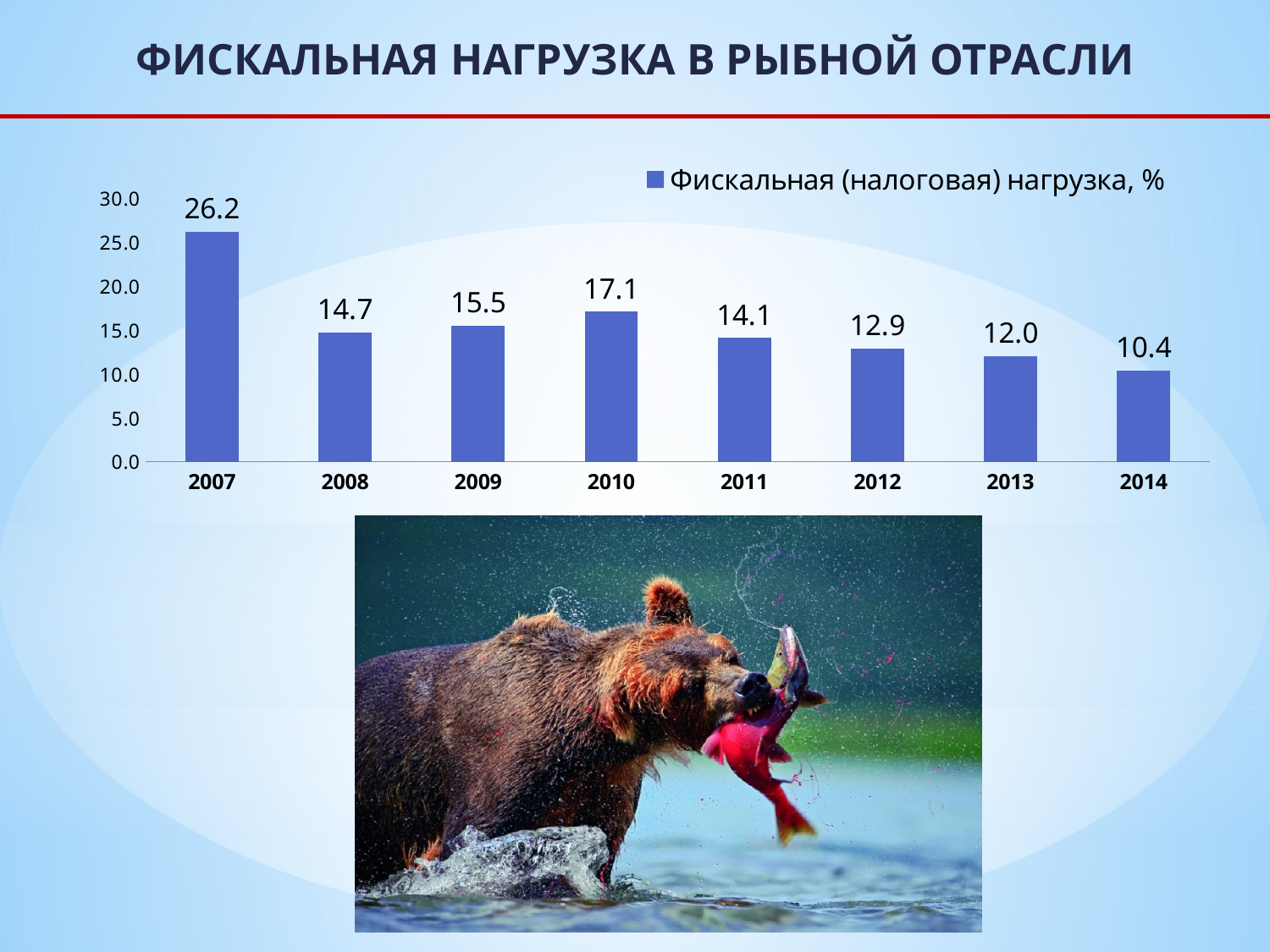
What is the value for 2012? 12.9 What is the value for 2010? 17.1 Is the value for 2013 greater or less than 15.0? less What is the legend entry for the series shown? Фискальная (налоговая) нагрузка, % Which year has the highest value? 2007 What is the difference between the values for 2007 and 2014? 15.8 What is the value for 2007? 26.2 What is the value for 2014? 10.4 How many years are shown on the x axis? 8 Which year has the lowest value? 2014 Which is larger, the value for 2009 or the value for 2011? 2009 What kind of chart is shown on the slide? bar chart